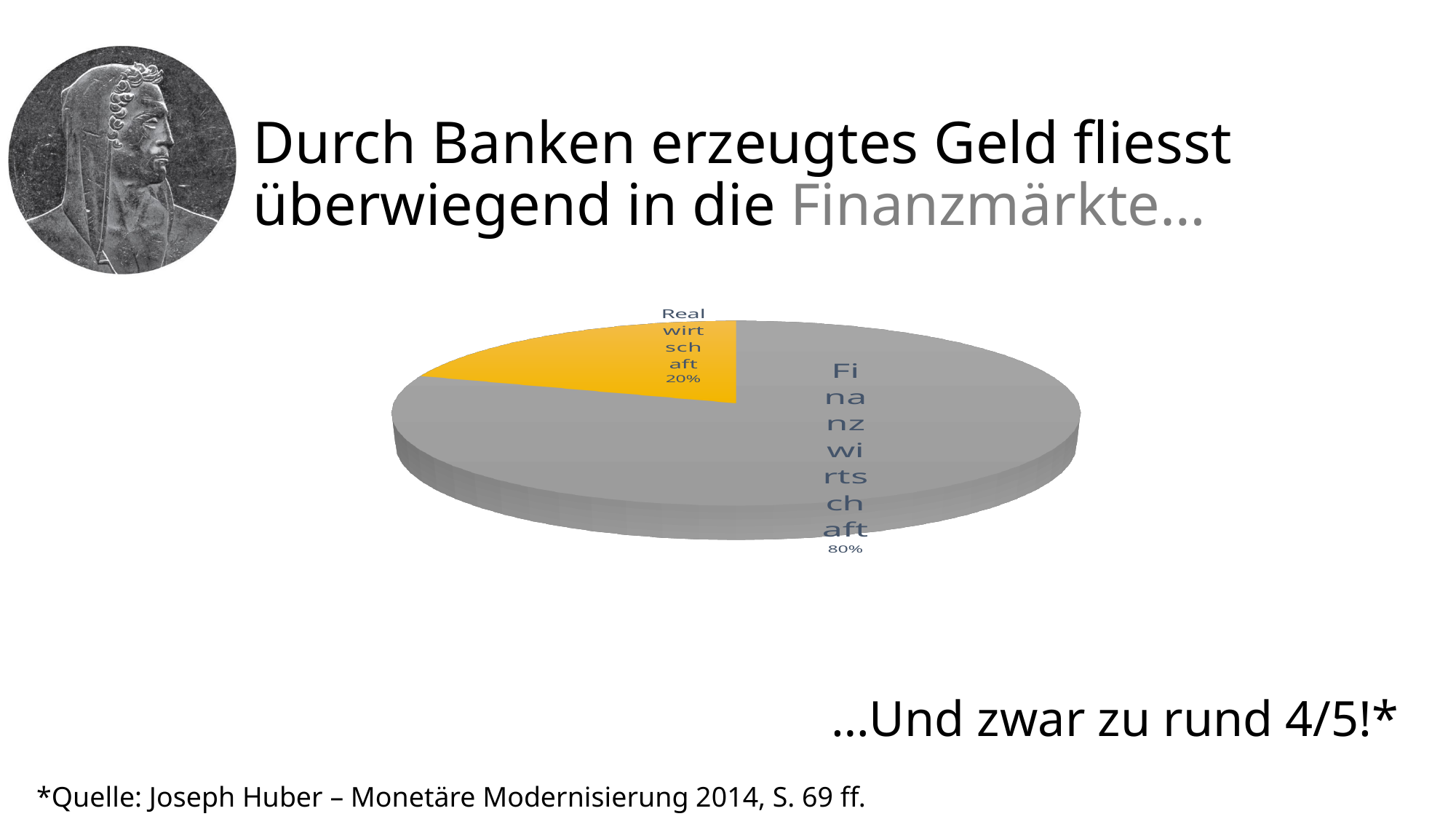
What colour is the Realwirtschaft slice? yellow What share of the pie does Finanzwirtschaft have? 80% How many slices does the pie chart have? 2 Which is larger, the Finanzwirtschaft slice or the Realwirtschaft slice? Finanzwirtschaft Which slice of the pie is the smallest? Realwirtschaft What is the difference in percentage points between the Finanzwirtschaft and Realwirtschaft slices? 60 Which slice of the pie is the largest? Finanzwirtschaft What colour is the Finanzwirtschaft slice? grey What share of the pie does Realwirtschaft have? 20% What kind of chart is shown on the slide? pie chart